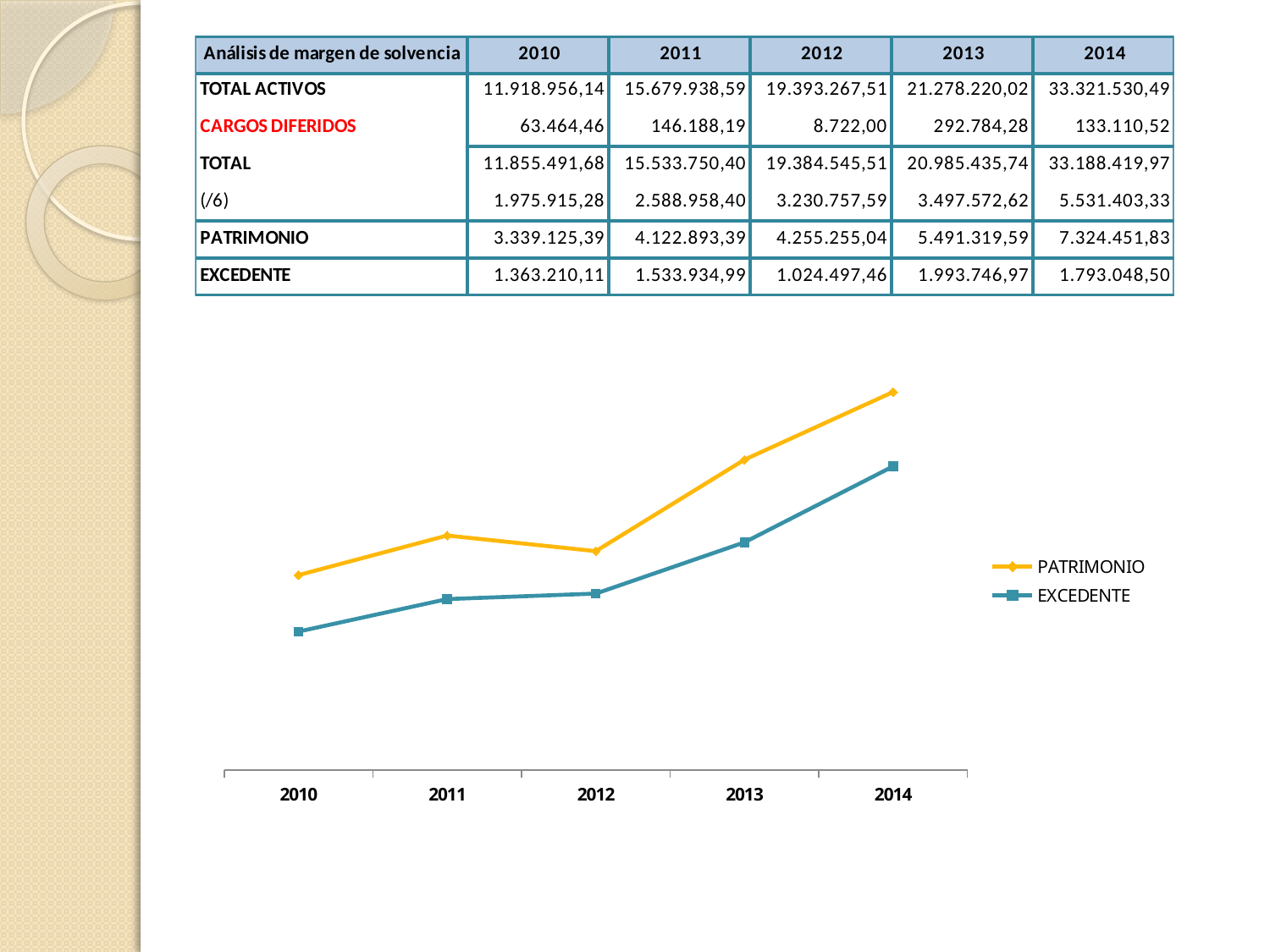
In which year is the EXCEDENTE line at its lowest point? 2010 In which year does the PATRIMONIO line reach its highest point? 2014 Which series in the chart is drawn with square markers? EXCEDENTE What colour is the PATRIMONIO line in the chart? yellow Is the PATRIMONIO line higher in 2011 or in 2012? 2011 Does the EXCEDENTE line generally rise or fall from 2010 to 2014? rise How many years are plotted along the x axis of the chart? 5 How many series does the chart's legend list? 2 What kind of chart is shown on the slide? line chart In which year is the PATRIMONIO line at its lowest point? 2010 In 2014, which series is higher on the chart, PATRIMONIO or EXCEDENTE? PATRIMONIO In which year does the EXCEDENTE line reach its highest point? 2014